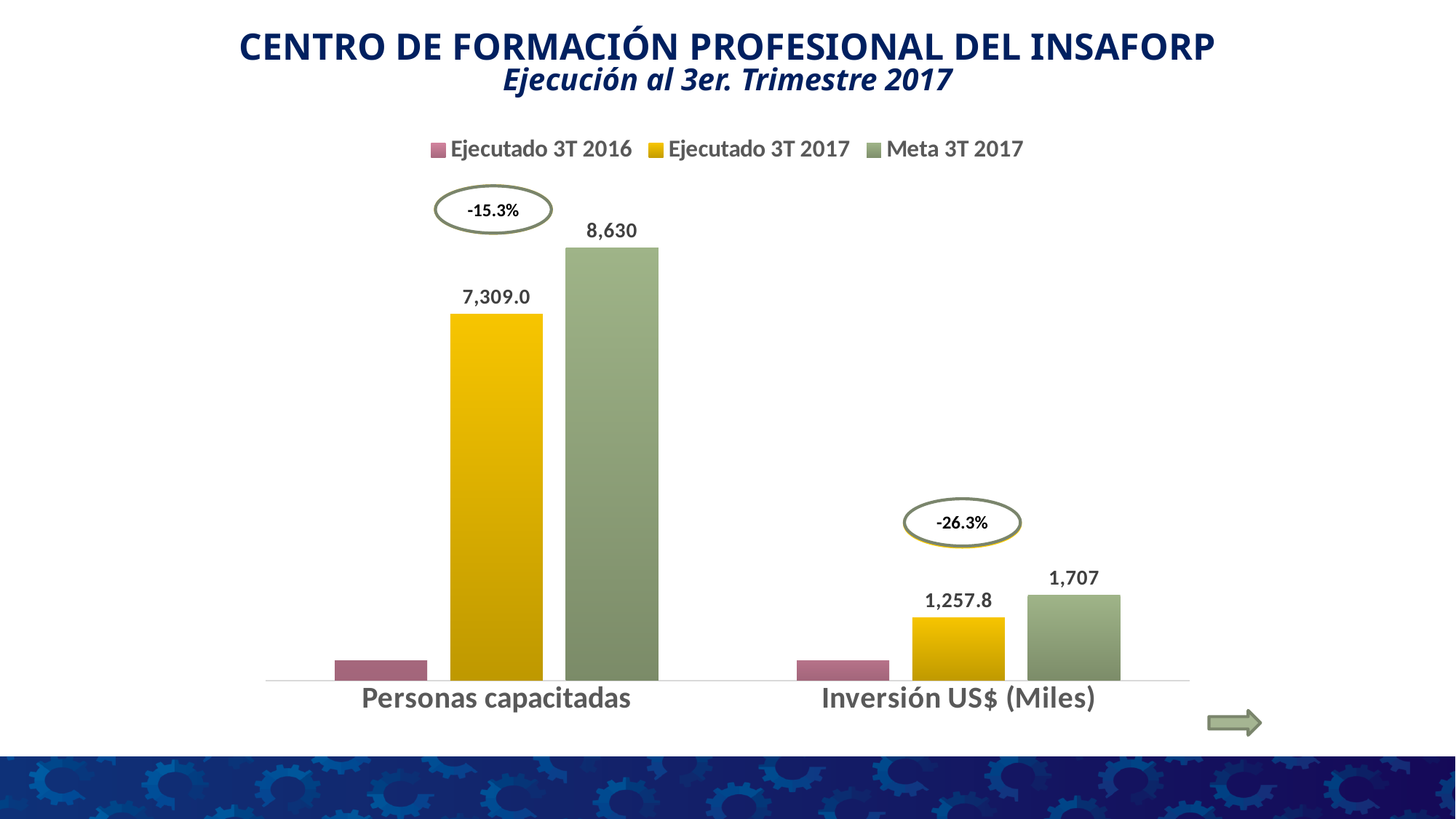
How many categories are shown on the x axis? 2 What is the Ejecutado 3T 2017 value for Personas capacitadas? 7,309.0 What type of chart is shown on the slide? bar chart Which is larger for Inversión US$ (Miles): Ejecutado 3T 2017 or Meta 3T 2017? Meta 3T 2017 What is the Meta 3T 2017 value for Personas capacitadas? 8,630 Which series has the highest bar for Personas capacitadas? Meta 3T 2017 What is the Meta 3T 2017 value for Inversión US$ (Miles)? 1,707 What is the Ejecutado 3T 2017 value for Inversión US$ (Miles)? 1,257.8 What percentage is shown in the oval annotation above the Personas capacitadas bars? -15.3% Which series has the lowest bar for Inversión US$ (Miles)? Ejecutado 3T 2016 How many series does the legend list? 3 What is the difference between the Meta 3T 2017 and Ejecutado 3T 2017 values for Personas capacitadas? 1,321.0